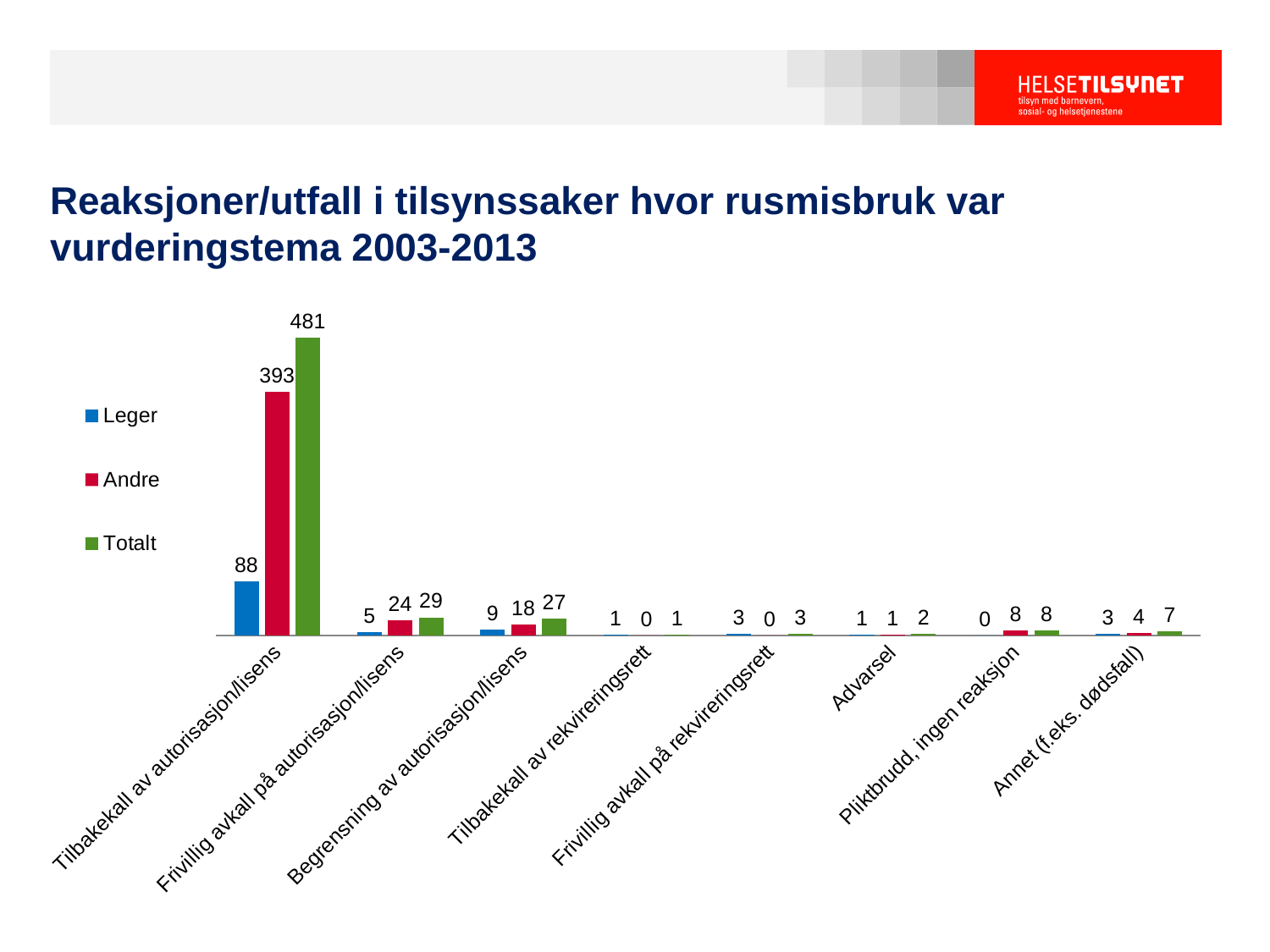
What is the value for Leger in the category Begrensning av autorisasjon/lisens? 9 How many categories are shown on the x axis? 8 What is the value for Andre in the category Pliktbrudd, ingen reaksjon? 8 What is the difference between the Totalt and Leger values for Tilbakekall av autorisasjon/lisens? 393 Which is larger for Annet (f.eks. dødsfall): the Leger value or the Andre value? Andre Which category has the highest Totalt value? Tilbakekall av autorisasjon/lisens What is the difference between the Andre values for Frivillig avkall på autorisasjon/lisens and Begrensning av autorisasjon/lisens? 6 How many series does the legend list? 3 Which category has the lowest Totalt value? Tilbakekall av rekvireringsrett What is the value for Andre in the category Tilbakekall av autorisasjon/lisens? 393 What kind of chart is shown on the slide? Bar chart What is the Totalt value for Frivillig avkall på autorisasjon/lisens? 29